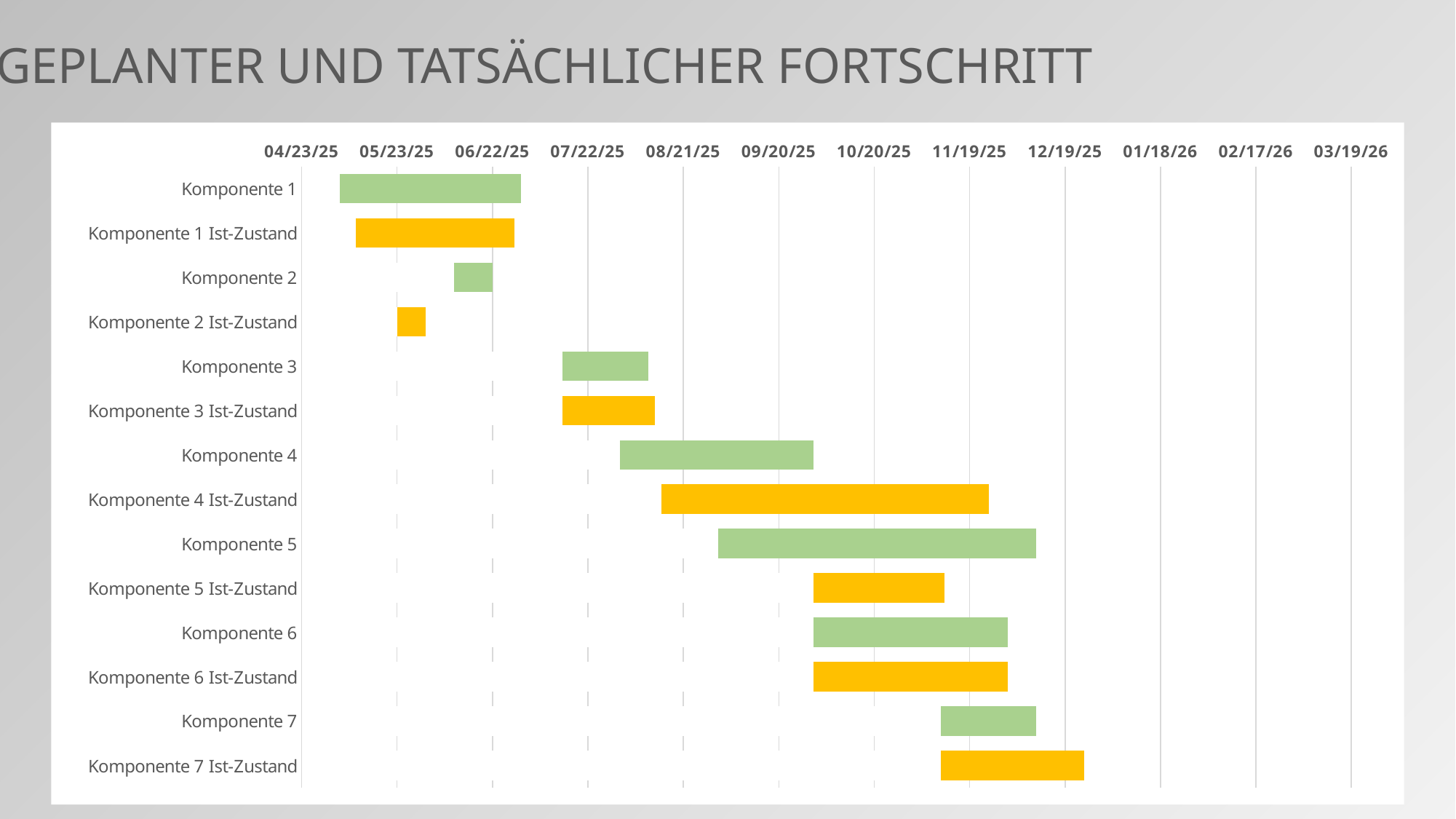
Which bar is longer, Komponente 1 or Komponente 2? Komponente 1 Which bar is longer, Komponente 5 or Komponente 5 Ist-Zustand? Komponente 5 What is the last date shown on the horizontal axis? 03/19/26 What is the first date shown on the horizontal axis? 04/23/25 What is the title of the slide? GEPLANTER UND TATSÄCHLICHER FORTSCHRITT What kind of chart is shown on the slide? Bar chart (Gantt chart) Does the bar for Komponente 1 start before or after 05/23/25? before What colour are the bars for the 'Ist-Zustand' rows? Yellow/orange Which bar is longer, Komponente 4 or Komponente 4 Ist-Zustand? Komponente 4 Ist-Zustand How many rows (categories) are listed on the vertical axis of the chart? 14 Does the bar for Komponente 4 start before or after 07/22/25? after Which row has the shortest bar? Komponente 2 Ist-Zustand